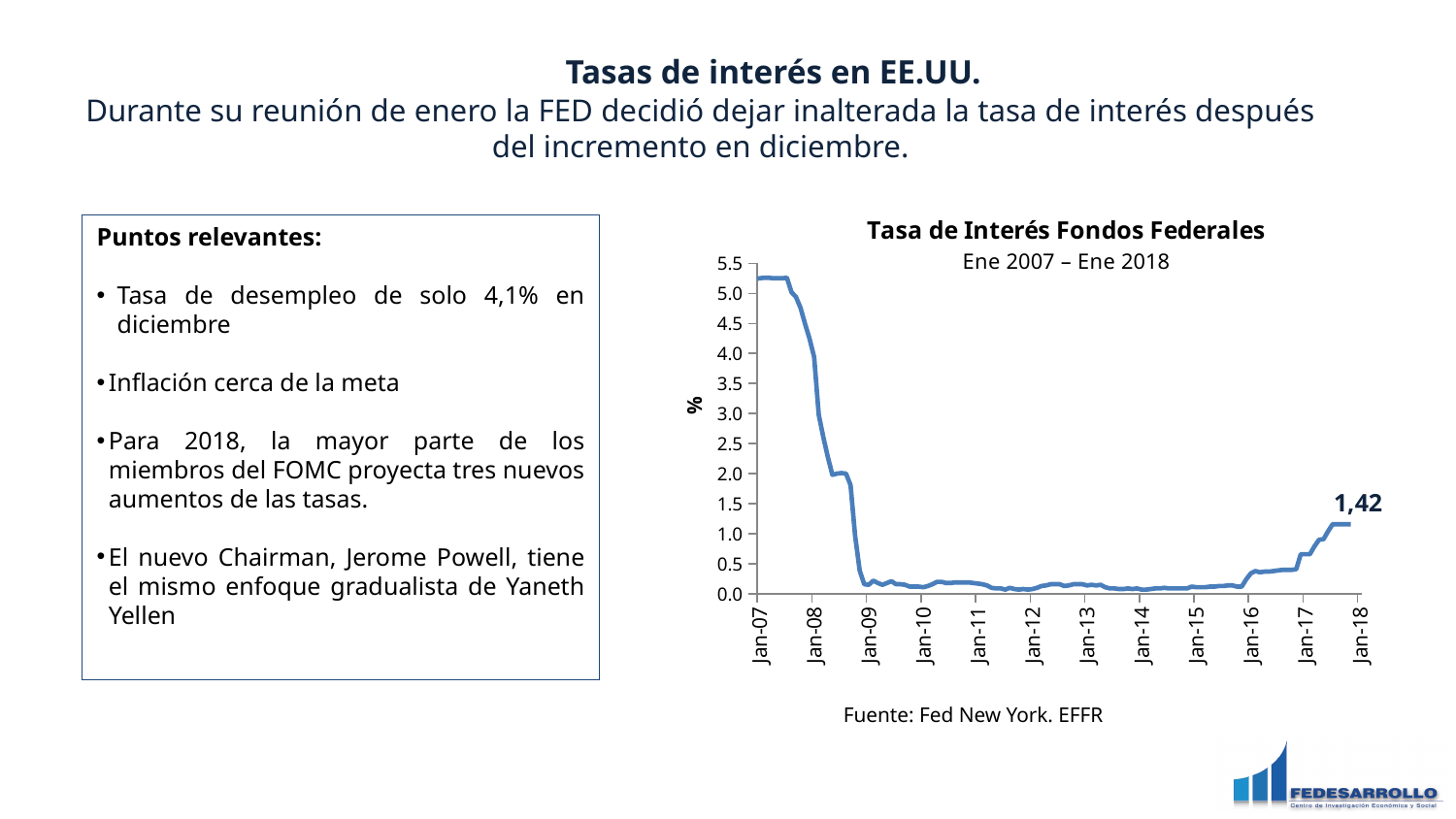
Is the value in Jan-07 greater or less than 5.0? greater Is the value in Jan-08 greater or less than 3.0? greater What value is labelled at the end of the line, in Jan-18? 1,42 Which is larger, the value in Jan-08 or the value in Jan-18? Jan-08 Is the value in Jan-17 greater or less than 1.0? less What is the title of the chart? Tasa de Interés Fondos Federales What is the label on the y axis? % Does the line rise or fall between Jan-07 and Jan-09? fall What kind of chart is shown on the slide? line chart Does the line rise or fall between Jan-16 and Jan-18? rise How many year labels are shown on the x axis? 12